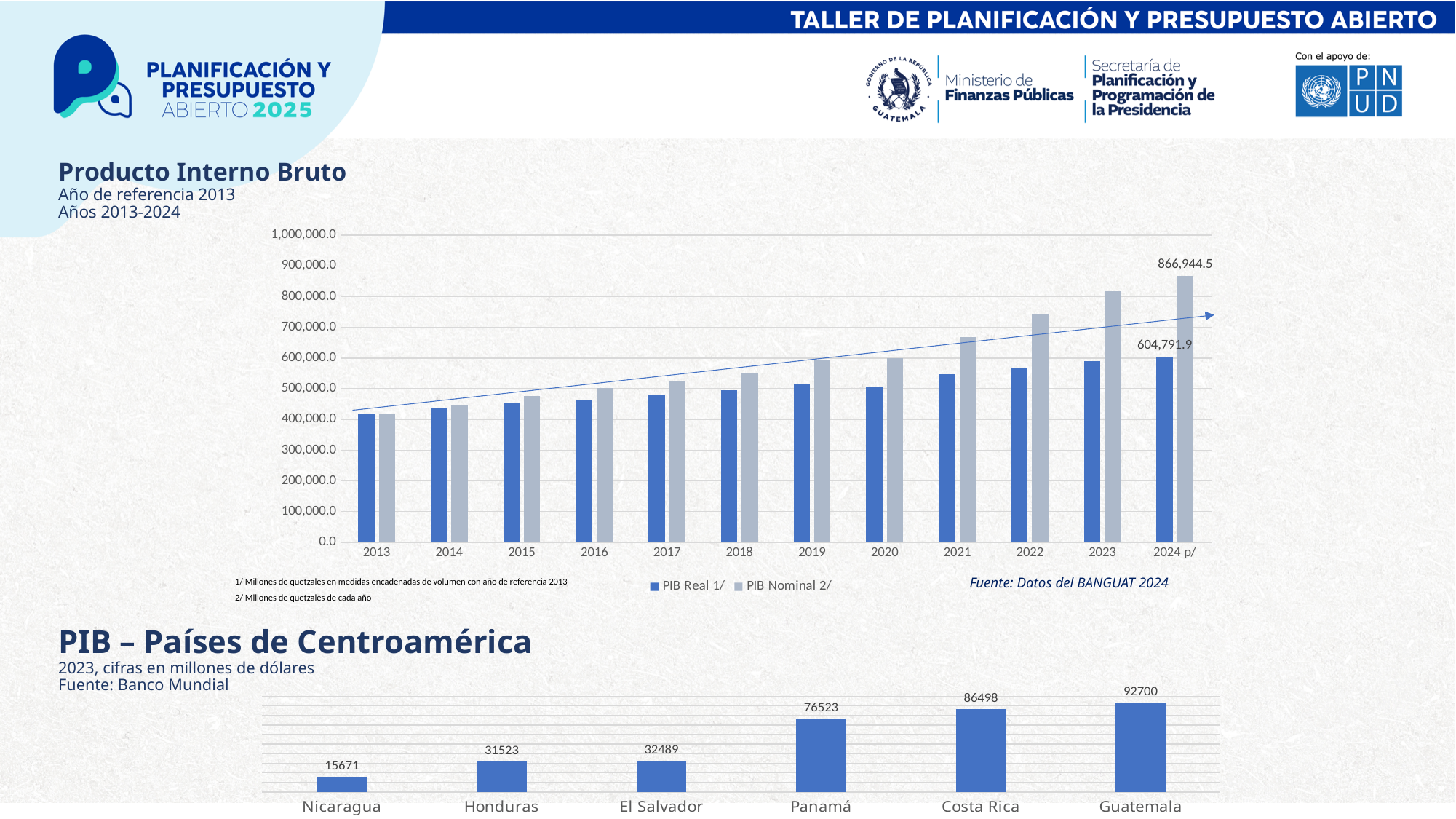
In the 'Producto Interno Bruto' chart, how many years are shown on the x axis? 12 In the 'PIB – Países de Centroamérica' chart, what is the value for Panamá? 76523 In the 'PIB – Países de Centroamérica' chart, which country has the lowest value? Nicaragua In the 'Producto Interno Bruto' chart, what is the PIB Real value for 2024 p/? 604,791.9 In the 'Producto Interno Bruto' chart, what is the PIB Nominal value for 2024 p/? 866,944.5 In the 'PIB – Países de Centroamérica' chart, which country has the highest value? Guatemala In the 'PIB – Países de Centroamérica' chart, what is the difference between Guatemala and Costa Rica? 6202 In the 'Producto Interno Bruto' chart, is the PIB Nominal value for 2022 greater or less than 800,000.0? less In the 'Producto Interno Bruto' chart, what is the difference between PIB Nominal and PIB Real for 2024 p/? 262,152.6 In the 'Producto Interno Bruto' chart, does PIB Nominal rise or fall from 2013 to 2024 p/? rise What kind of chart is the 'PIB – Países de Centroamérica' chart? bar chart In the 'Producto Interno Bruto' chart, how many series does the legend list? 2